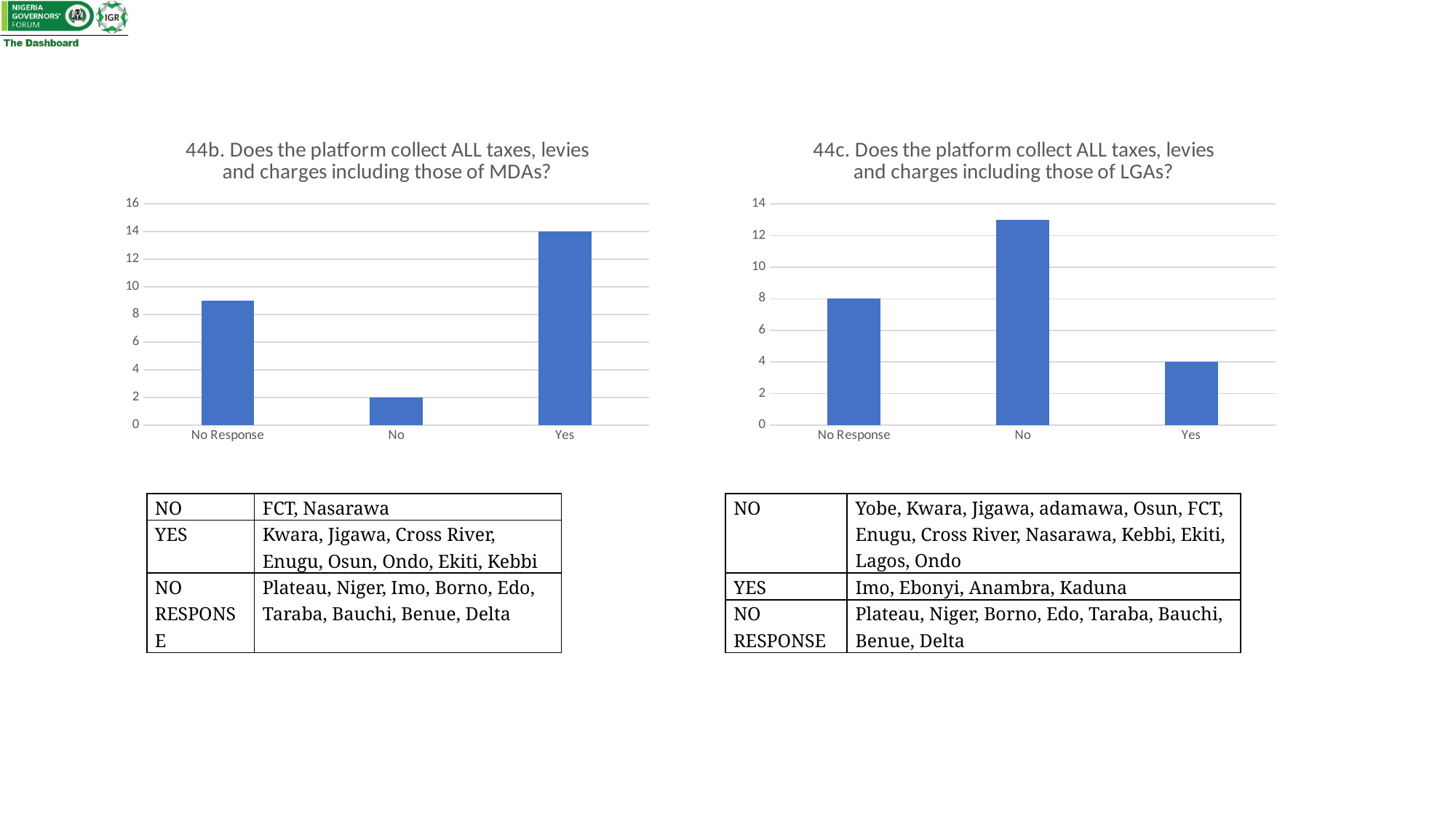
In the right chart (44c, LGAs), which category has the lowest value? Yes What kind of chart is the right chart (44c, LGAs)? bar chart In the right chart (44c, LGAs), which category has the highest value? No In the left chart (44b, MDAs), which category has the highest value? Yes In the right chart (44c, LGAs), is the value for No greater or less than 12? greater In the chart titled "44b. Does the platform collect ALL taxes, levies and charges including those of MDAs?", what is the value for No? 2 How many categories are shown on the x axis of the left chart (44b, MDAs)? 3 In the chart titled "44c. Does the platform collect ALL taxes, levies and charges including those of LGAs?", what is the value for Yes? 4 In the chart titled "44c. Does the platform collect ALL taxes, levies and charges including those of LGAs?", what is the value for No Response? 8 In the left chart (44b, MDAs), what is the difference between the values for Yes and No? 12 In the left chart (44b, MDAs), is the value for No Response greater or less than 8? greater In the chart titled "44b. Does the platform collect ALL taxes, levies and charges including those of MDAs?", what is the value for Yes? 14